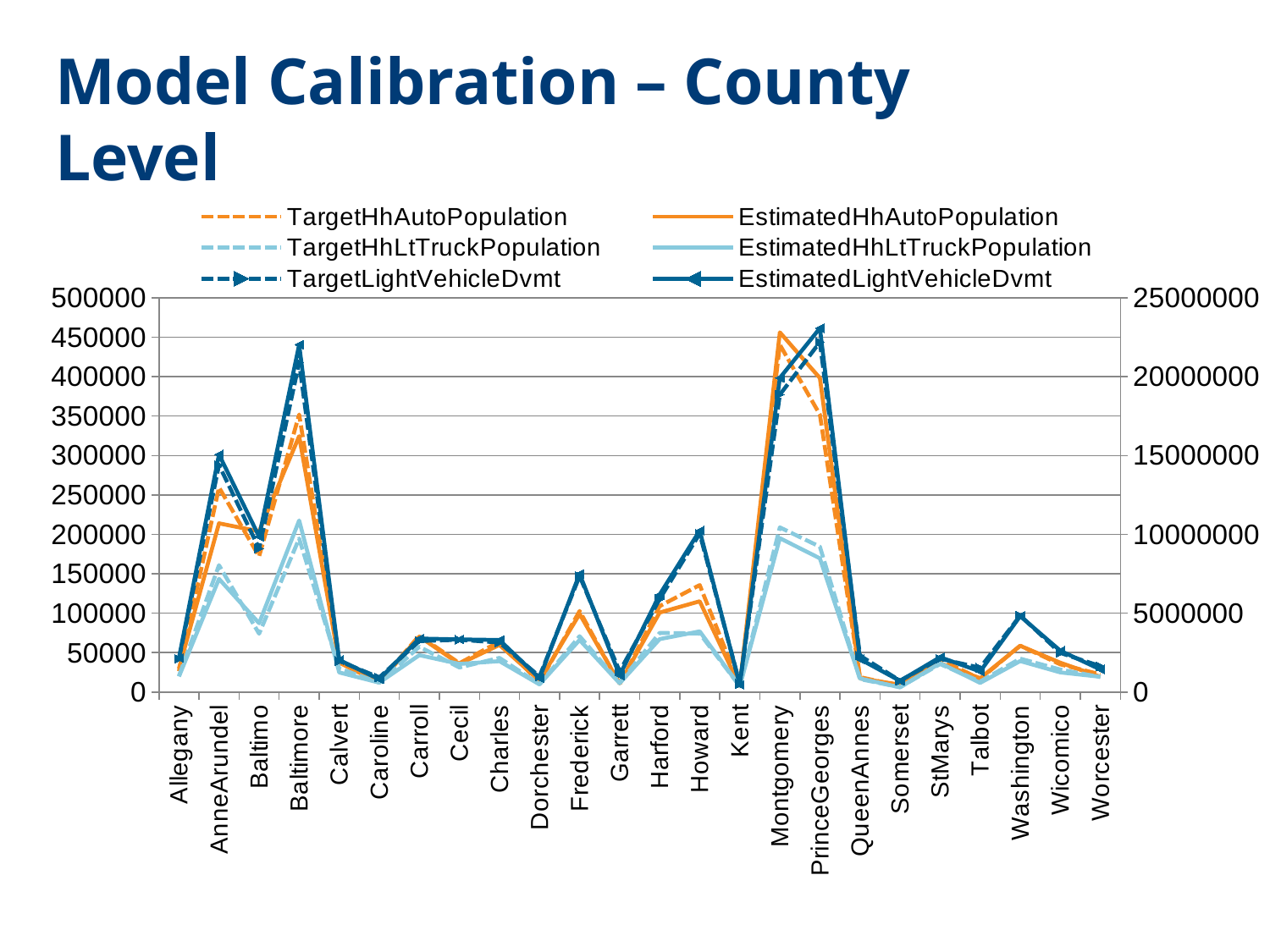
Which county has the highest TargetHhAutoPopulation value? Montgomery Which county has the larger EstimatedLightVehicleDvmt value, Baltimore or Calvert? Baltimore Is the EstimatedHhAutoPopulation value for Baltimore greater or less than 250000? greater Which county has the larger TargetHhAutoPopulation value, Montgomery or Kent? Montgomery Is the TargetHhAutoPopulation value for Montgomery greater or less than 400000? greater Is the EstimatedHhLtTruckPopulation value for Montgomery greater or less than 150000? greater How many counties are plotted along the x axis? 24 Which county has the highest EstimatedLightVehicleDvmt value? PrinceGeorges How many series does the legend list? 6 What kind of chart is shown on the slide? line chart What is the title of the slide containing the chart? Model Calibration – County Level